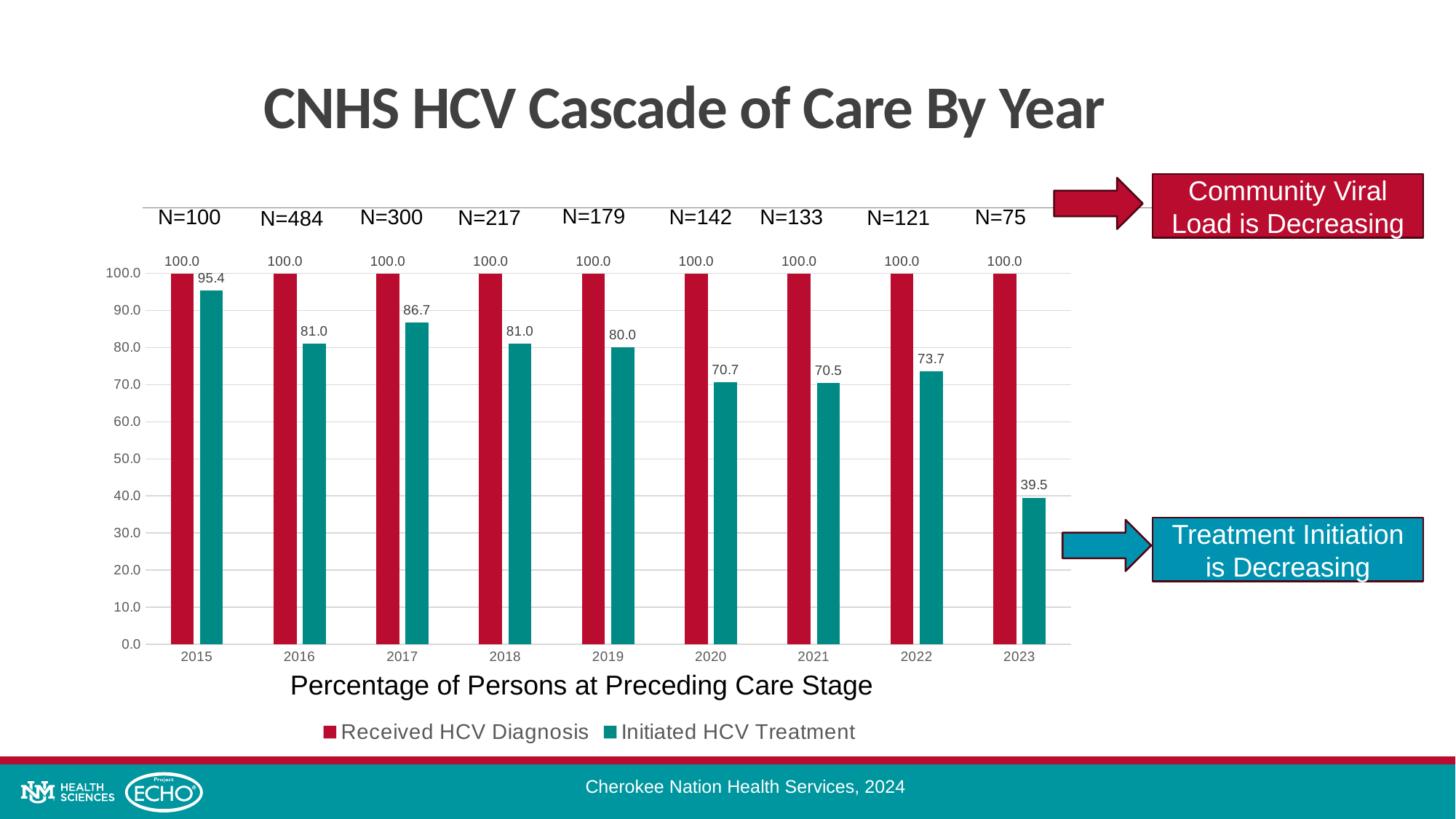
Which year has the highest value for Initiated HCV Treatment? 2015 Which is larger, the Initiated HCV Treatment value for 2022 or for 2020? 2022 How many series does the legend list? 2 What is the difference between the Initiated HCV Treatment values for 2015 and 2023? 55.9 Which year has the lowest value for Initiated HCV Treatment? 2023 What kind of chart is shown on the slide? Bar chart How many years are shown on the x axis? 9 What is the value for Initiated HCV Treatment in 2023? 39.5 Does the Initiated HCV Treatment value generally rise or fall from 2015 to 2023? Fall What is the value for Initiated HCV Treatment in 2017? 86.7 What is the N value shown above the 2016 bars? N=484 What is the value for Received HCV Diagnosis in 2019? 100.0